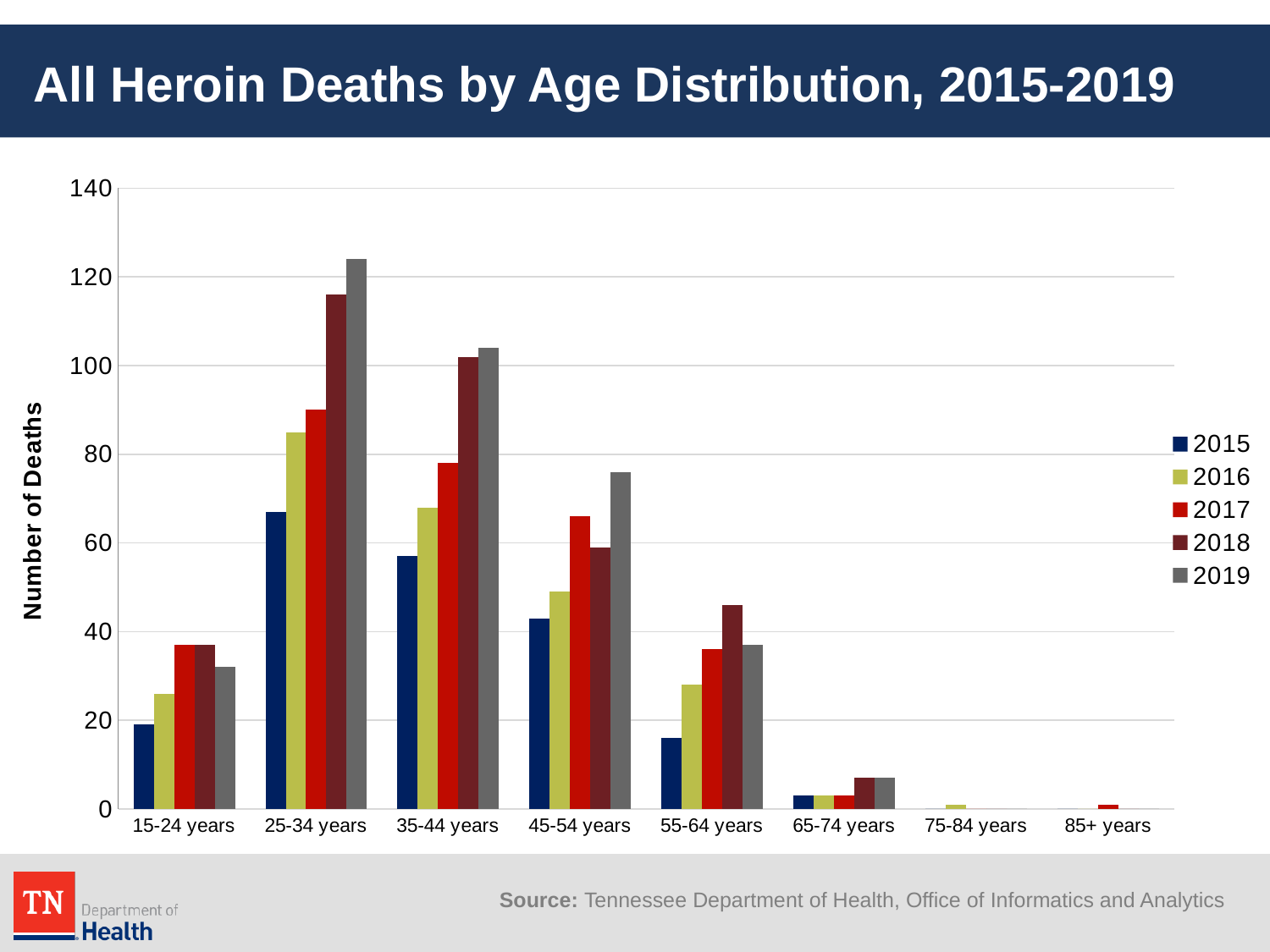
Which year has the lowest number of deaths in the 45-54 years group? 2015 What kind of chart is shown on the slide? Bar chart For the 25-34 years group, do the values rise or fall from 2015 to 2019? rise Is the value for 2019 in the 25-34 years group greater or less than 100? greater How many series does the legend list? 5 What is the title of the y axis? Number of Deaths In the 35-44 years group, which is larger, the value for 2017 or the value for 2018? 2018 Is the value for 2016 in the 55-64 years group greater or less than 40? less How many age groups are shown on the x axis? 8 Which age group has the highest number of deaths for 2019? 25-34 years In the 55-64 years group, which is larger, the value for 2018 or the value for 2019? 2018